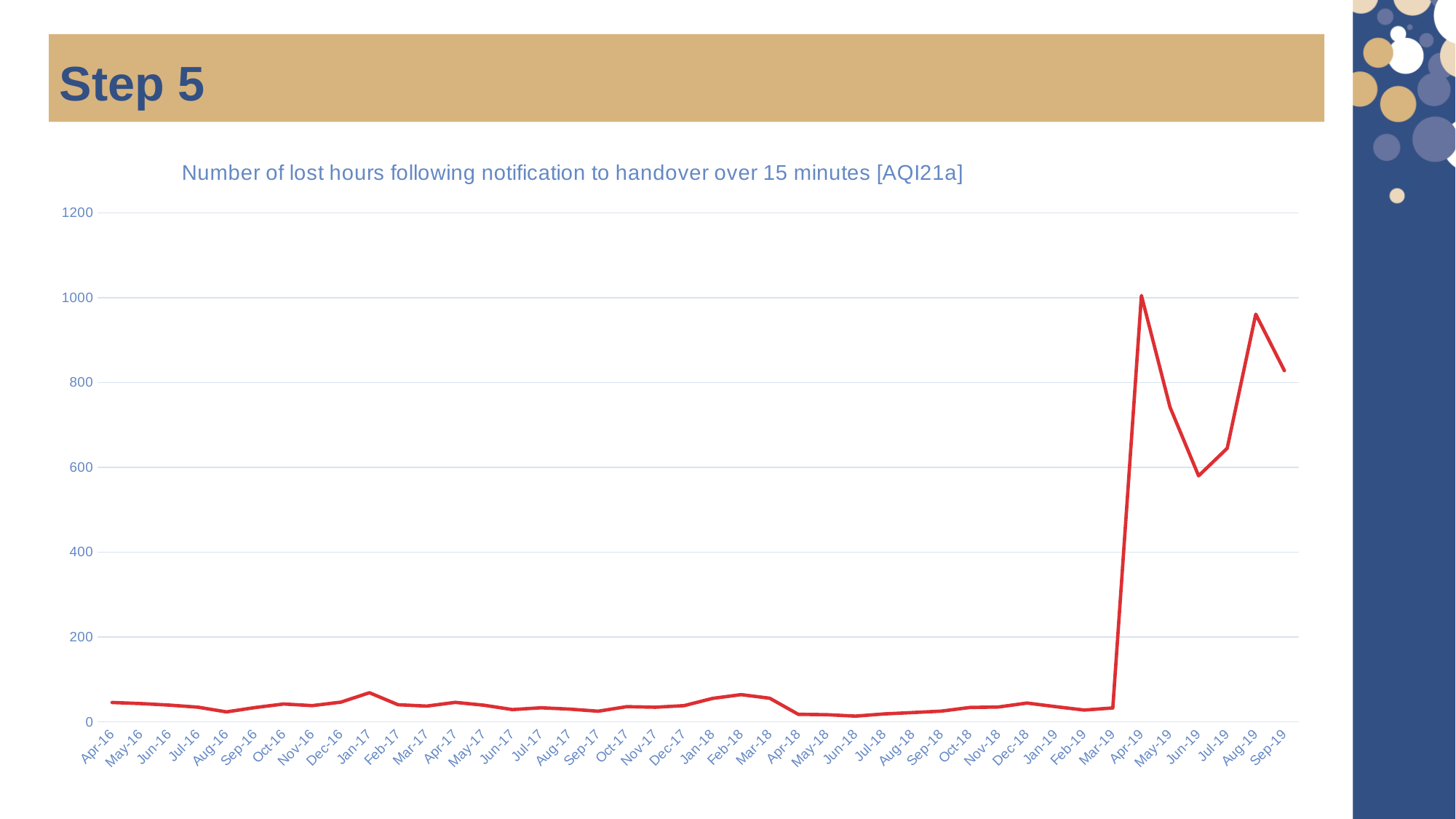
Is the value for Apr-19 greater or less than 800? greater Is the value for Jun-19 greater or less than 400? greater How many monthly points are plotted on the x axis, from Apr-16 to Sep-19? 42 Which is larger, the value for Apr-19 or the value for Mar-19? Apr-19 What colour is the plotted line? red What is the title of the chart? Number of lost hours following notification to handover over 15 minutes [AQI21a] Do the values rise or fall from Apr-19 to Jun-19? fall Which month has the highest number of lost hours? Apr-19 What kind of chart is shown on the slide? line chart Which is larger, the value for Aug-19 or the value for Jun-19? Aug-19 Is the value for Aug-19 greater or less than 800? greater